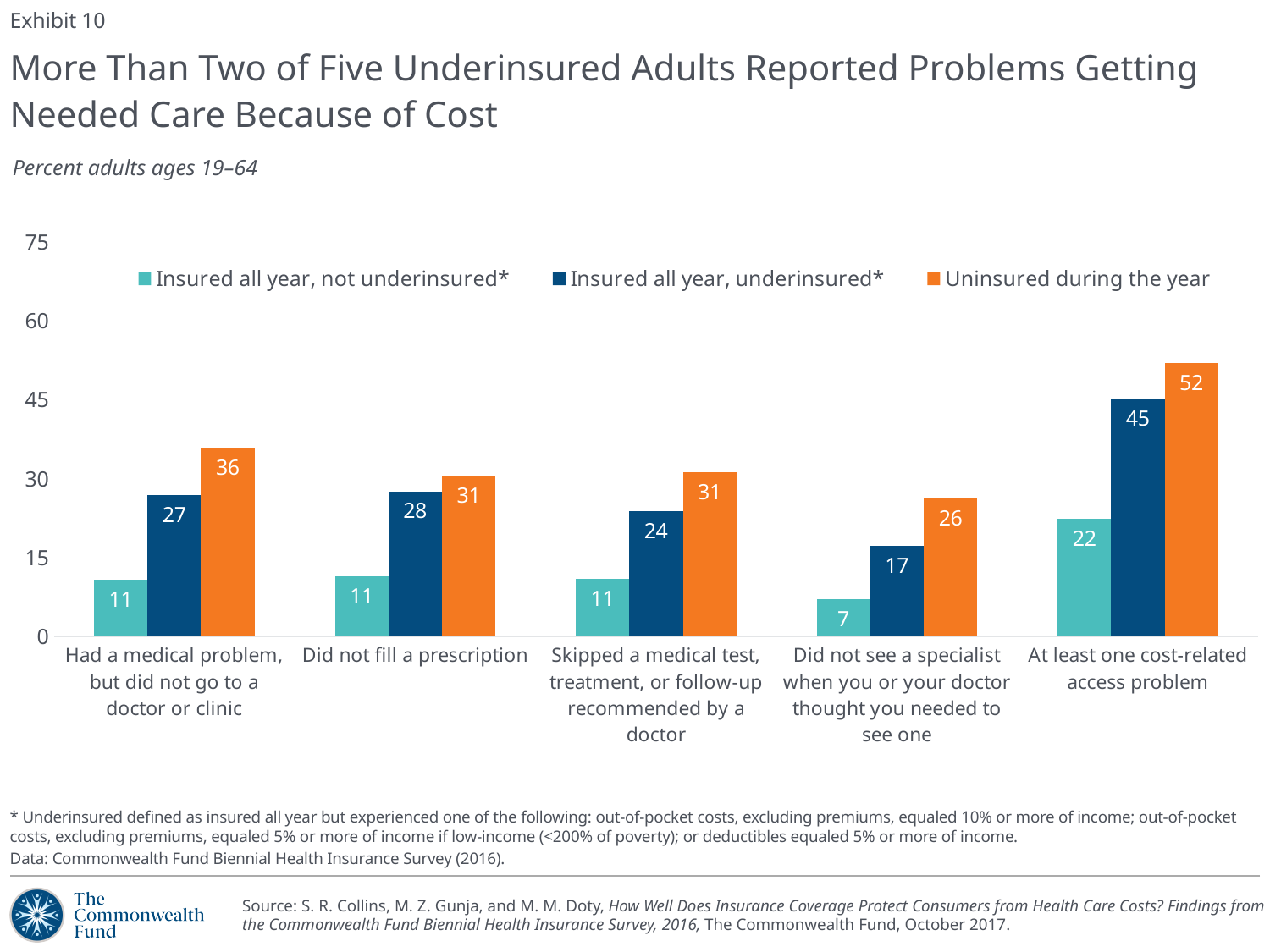
What colour represents the 'Uninsured during the year' series? Orange How many categories are shown on the x axis? 5 Which category has the highest value for the 'Uninsured during the year' series? At least one cost-related access problem What kind of chart is shown on the slide? Bar chart What is the value for 'Uninsured during the year' in the 'At least one cost-related access problem' category? 52 What is the value for 'Insured all year, underinsured*' in the 'Did not fill a prescription' category? 28 In the 'Skipped a medical test, treatment, or follow-up recommended by a doctor' category, which is larger: 'Insured all year, underinsured*' or 'Uninsured during the year'? Uninsured during the year Which category has the lowest value for the 'Insured all year, underinsured*' series? Did not see a specialist when you or your doctor thought you needed to see one What is the value for 'Insured all year, not underinsured*' in the 'Did not see a specialist when you or your doctor thought you needed to see one' category? 7 Is the value for 'Insured all year, underinsured*' in the 'At least one cost-related access problem' category greater or less than 30? greater What is the difference between the 'Uninsured during the year' and 'Insured all year, not underinsured*' values in the 'At least one cost-related access problem' category? 30 How many series does the legend list? 3